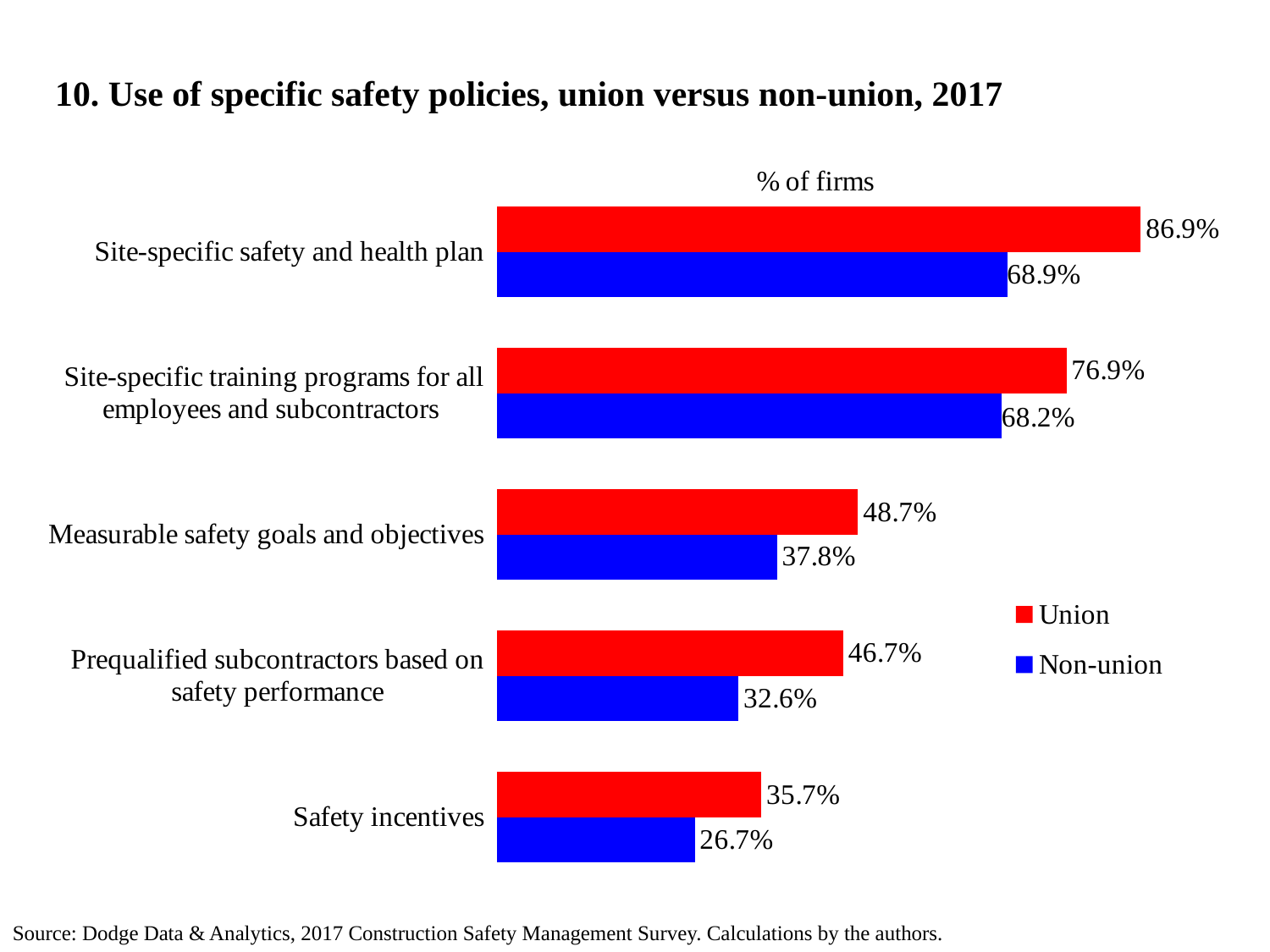
How many series does the legend list? 2 Which is larger: the union value for measurable safety goals and objectives or the union value for prequalified subcontractors based on safety performance? Measurable safety goals and objectives What is the difference between the union and non-union values for site-specific safety and health plan? 18.0% Which colour represents non-union firms in the chart? Blue What is the difference between the union and non-union values for prequalified subcontractors based on safety performance? 14.1% Which safety policy has the highest union value? Site-specific safety and health plan What is the non-union value for measurable safety goals and objectives? 37.8% What kind of chart is shown on the slide? Bar chart How many safety policies are shown on the chart? 5 What percentage of union firms use a site-specific safety and health plan? 86.9% Which safety policy has the lowest non-union value? Safety incentives What percentage of non-union firms use safety incentives? 26.7%